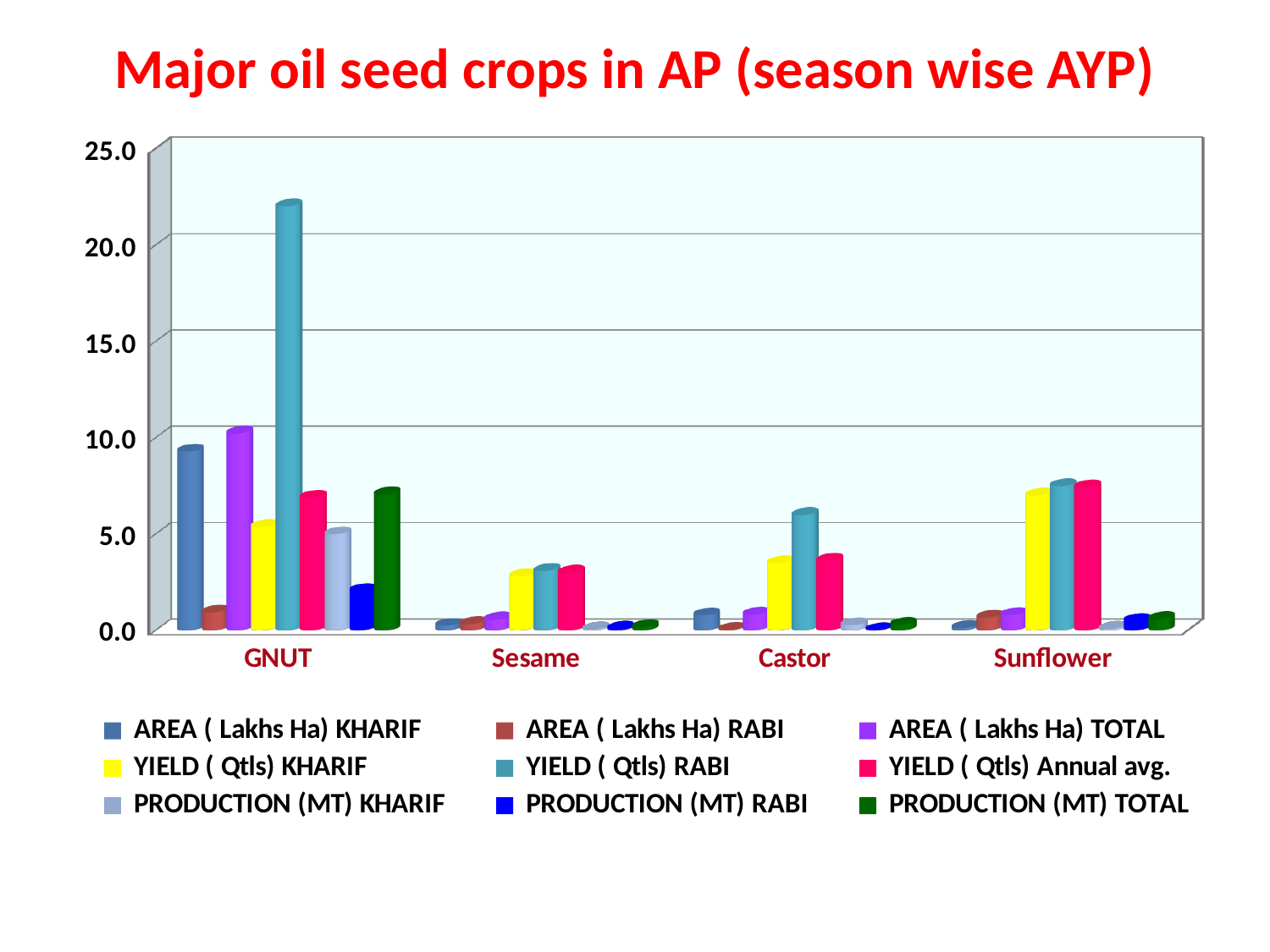
Which series is shown in dark green in the legend? PRODUCTION (MT) TOTAL Is the YIELD ( Qtls) RABI value for GNUT greater or less than 20.0? greater Is the AREA ( Lakhs Ha) KHARIF value for GNUT greater or less than 5.0? greater Which crop has the highest YIELD ( Qtls) RABI value? GNUT How many crop categories are shown on the x axis? 4 What kind of chart is shown on the slide? Bar chart Is the YIELD ( Qtls) RABI value for Castor greater or less than 5.0? greater How many series does the legend list? 9 Which crop has the highest YIELD ( Qtls) KHARIF value? Sunflower Which is larger, the AREA ( Lakhs Ha) KHARIF value for GNUT or for Castor? GNUT What is the title of the chart? Major oil seed crops in AP (season wise AYP)